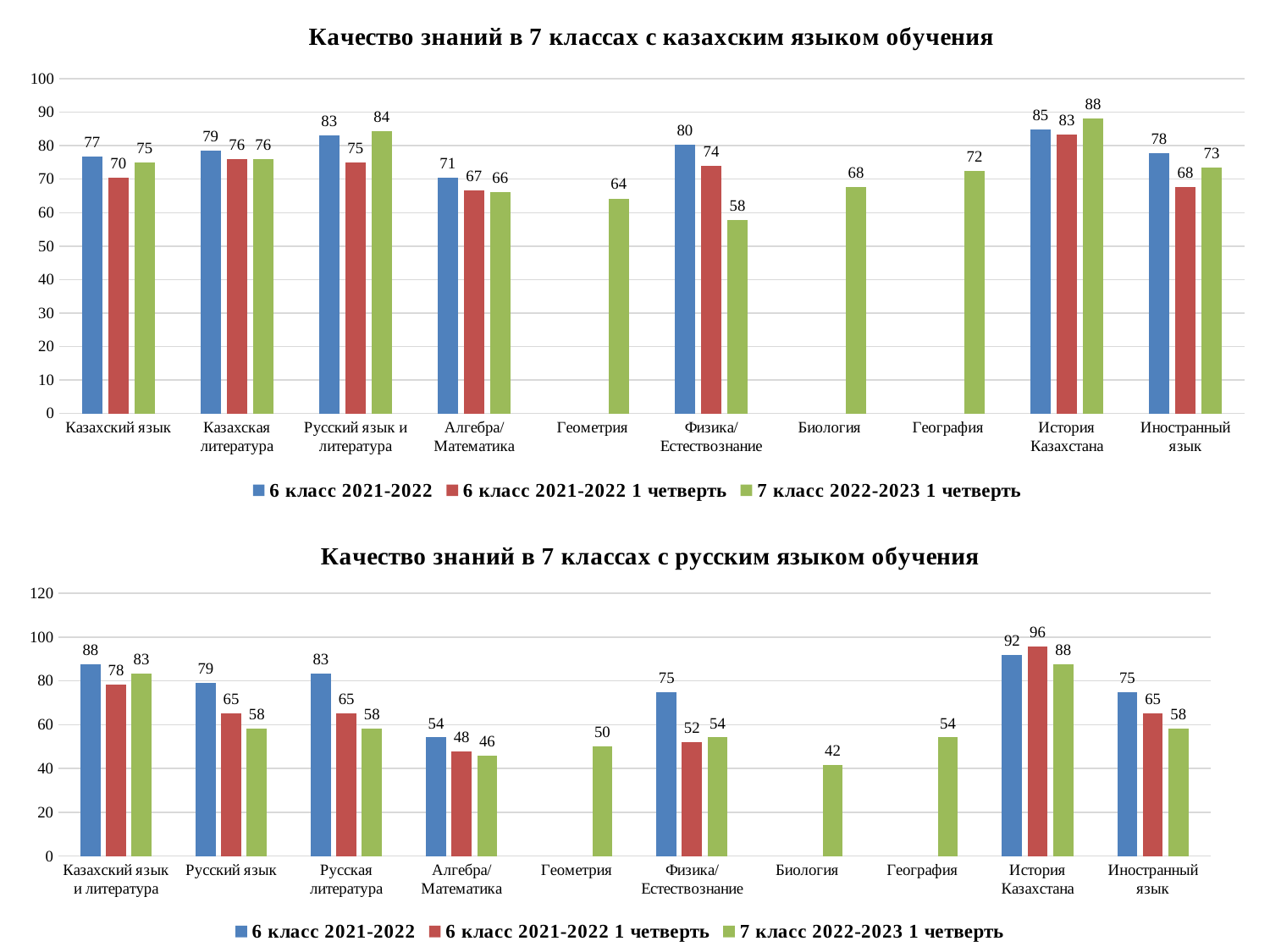
In the chart 'Качество знаний в 7 классах с казахским языком обучения', what is the difference between the '6 класс 2021-2022' and '7 класс 2022-2023 1 четверть' values for Физика/Естествознание? 22 In the chart 'Качество знаний в 7 классах с казахским языком обучения', what is the value for Казахский язык in the series '6 класс 2021-2022'? 77 What kind of chart is 'Качество знаний в 7 классах с русским языком обучения'? Bar chart In the chart 'Качество знаний в 7 классах с казахским языком обучения', what is the value for Физика/Естествознание in the series '7 класс 2022-2023 1 четверть'? 58 In the chart 'Качество знаний в 7 классах с русским языком обучения', what is the difference between the '6 класс 2021-2022' and '7 класс 2022-2023 1 четверть' values for Русский язык? 21 In the chart 'Качество знаний в 7 классах с русским языком обучения', what is the value for История Казахстана in the series '6 класс 2021-2022 1 четверть'? 96 In the chart 'Качество знаний в 7 классах с казахским языком обучения', which category has the highest value in the series '7 класс 2022-2023 1 четверть'? История Казахстана In the chart 'Качество знаний в 7 классах с русским языком обучения', what is the value for Биология in the series '7 класс 2022-2023 1 четверть'? 42 In the chart 'Качество знаний в 7 классах с казахским языком обучения', how many series does the legend list? 3 In the chart 'Качество знаний в 7 классах с казахским языком обучения', how many categories are shown on the x axis? 10 In the chart 'Качество знаний в 7 классах с русским языком обучения', which is larger for Алгебра/Математика: the '6 класс 2021-2022' value or the '7 класс 2022-2023 1 четверть' value? 6 класс 2021-2022 In the chart 'Качество знаний в 7 классах с русским языком обучения', which category has the lowest value in the series '7 класс 2022-2023 1 четверть'? Биология